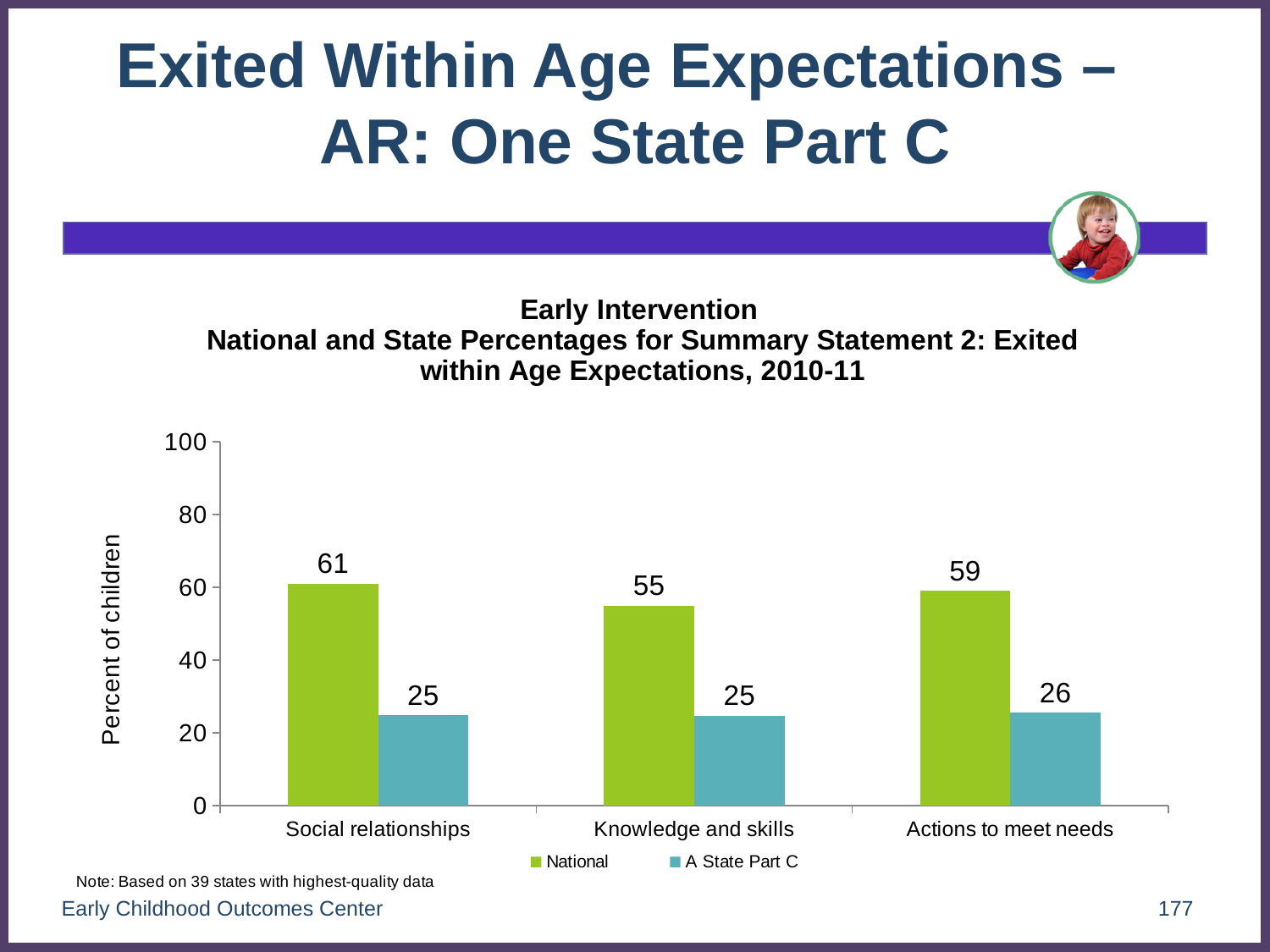
What is the difference between the National and A State Part C values for Actions to meet needs? 33 Which category has the highest National value? Social relationships Which category has the lowest National value? Knowledge and skills How many categories are shown on the x axis? 3 Which is larger for Knowledge and skills, the National value or the A State Part C value? National What is the difference between the National and A State Part C values for Social relationships? 36 How many series does the legend list? 2 What is the A State Part C value for Actions to meet needs? 26 What is the National value for Social relationships? 61 What is the label of the y axis? Percent of children What is the National value for Knowledge and skills? 55 What kind of chart is shown on the slide? Bar chart